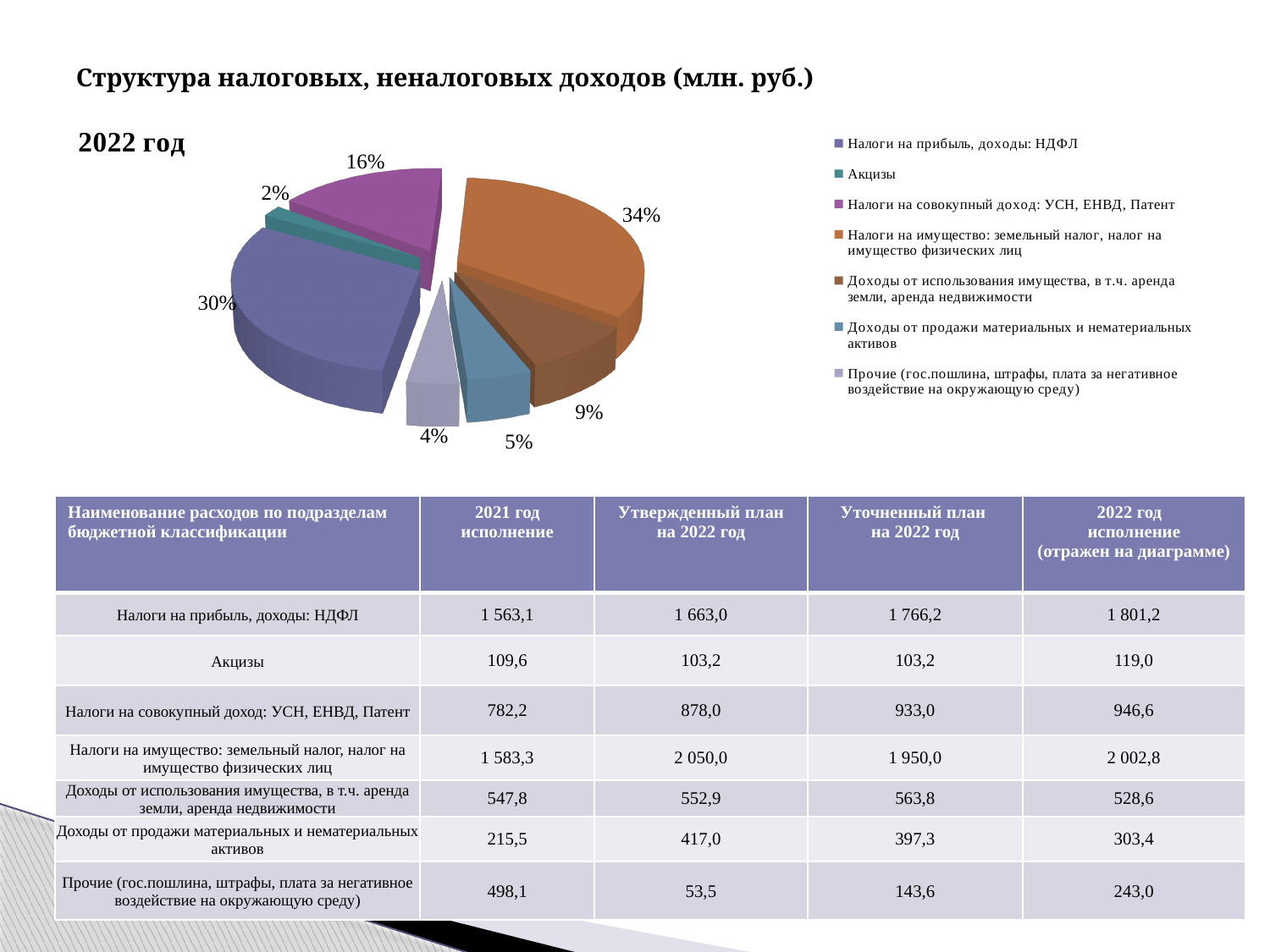
What is the difference in percentage points between the share for "Налоги на имущество" and the share for "Налоги на прибыль, доходы: НДФЛ"? 4 percentage points How many categories does the legend of the pie chart list? 7 Which year does the pie chart represent, according to the label next to it? 2022 год What share of the pie does "Доходы от использования имущества, в т.ч. аренда земли, аренда недвижимости" have? 9% What share of the pie does "Налоги на совокупный доход: УСН, ЕНВД, Патент" have? 16% What share of the pie does "Налоги на прибыль, доходы: НДФЛ" have? 30% Which category has the largest slice of the pie? Налоги на имущество: земельный налог, налог на имущество физических лиц Which category has the smallest slice of the pie? Акцизы Which has a larger share of the pie: "Доходы от продажи материальных и нематериальных активов" or "Прочие (гос.пошлина, штрафы, плата за негативное воздействие на окружающую среду)"? Доходы от продажи материальных и нематериальных активов What kind of chart is shown on the slide? pie chart